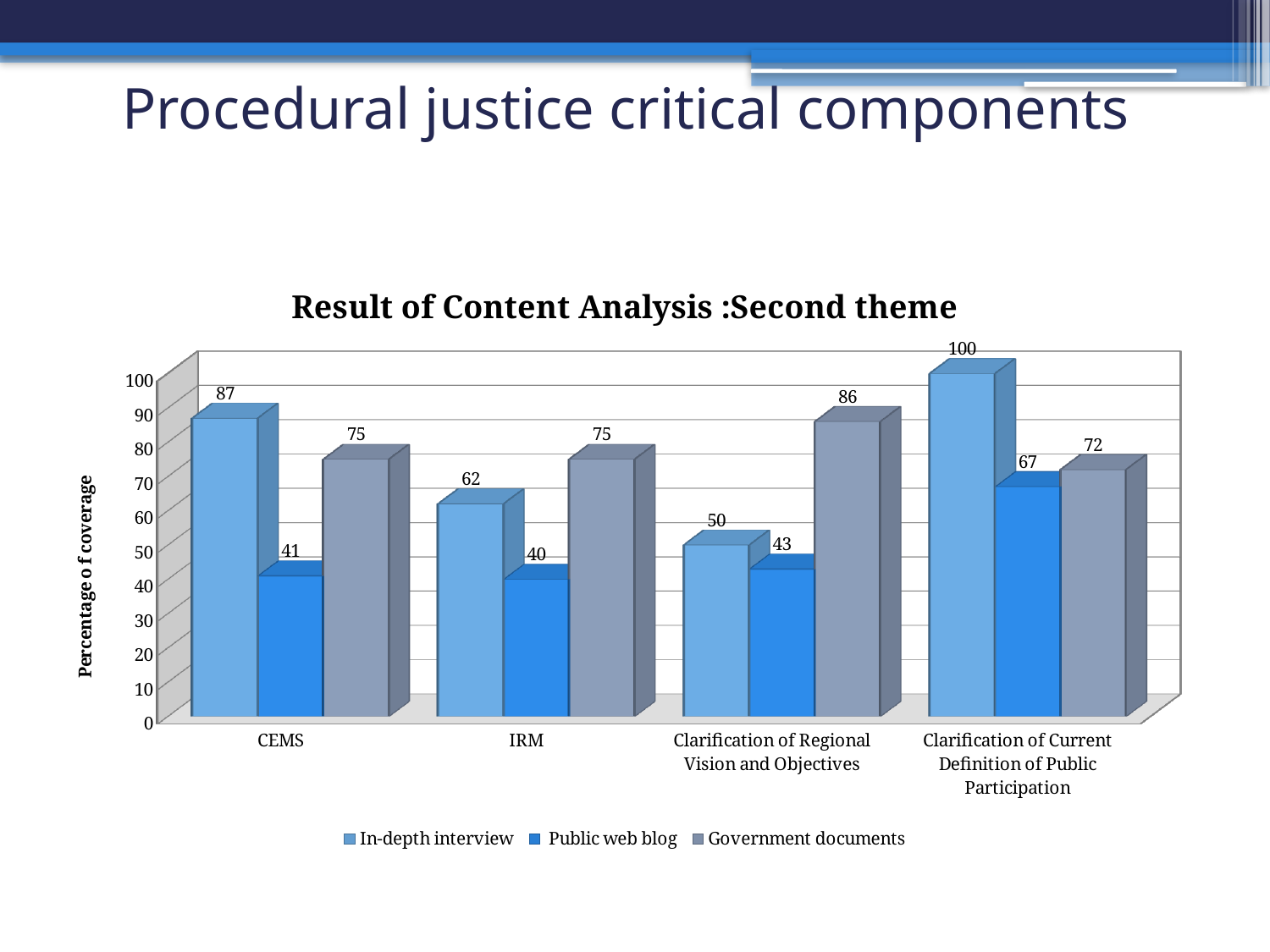
How many categories are shown on the x axis? 4 What is the difference between the Government documents value and the Public web blog value for CEMS? 34 How many series does the legend list? 3 Which category has the lowest Public web blog value? IRM What is the Public web blog value for IRM? 40 What is the Public web blog value for Clarification of Current Definition of Public Participation? 67 What kind of chart is shown on the slide? Bar chart What is the In-depth interview value for CEMS? 87 What is the title of the chart? Result of Content Analysis :Second theme Which category has the highest In-depth interview value? Clarification of Current Definition of Public Participation What is the Government documents value for Clarification of Regional Vision and Objectives? 86 Which is larger for IRM: the In-depth interview value or the Government documents value? Government documents